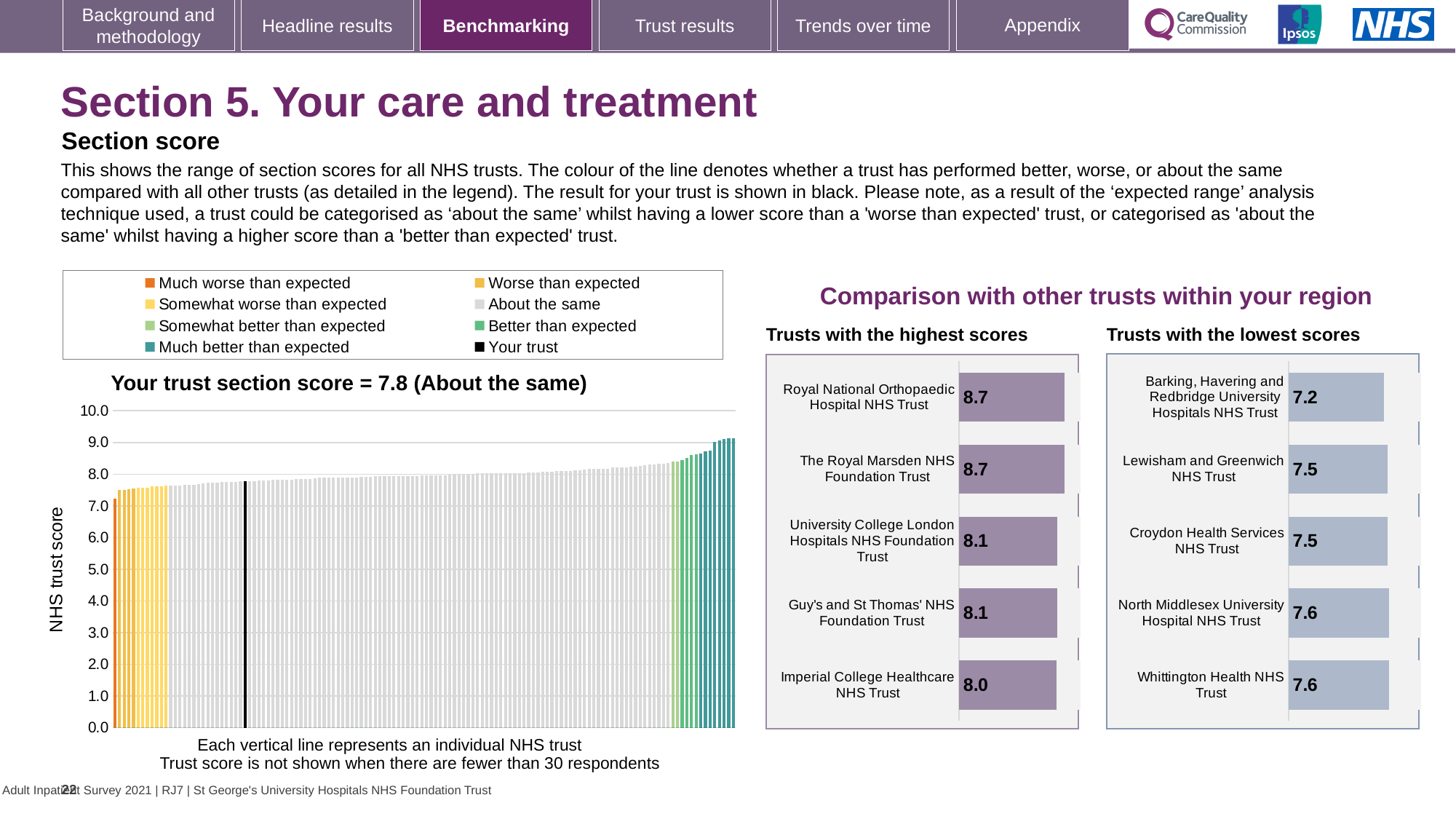
On the 'Trusts with the lowest scores' chart, what is the score for Croydon Health Services NHS Trust? 7.5 On the 'Trusts with the highest scores' chart, what is the score for Imperial College Healthcare NHS Trust? 8.0 On the 'Your trust section score' chart, is the value of the leftmost (lowest) bar greater or less than 7.0? greater On the 'Trusts with the highest scores' chart, what is the difference between the scores of Royal National Orthopaedic Hospital NHS Trust and Imperial College Healthcare NHS Trust? 0.7 On the 'Trusts with the highest scores' chart, which trust has the lowest score? Imperial College Healthcare NHS Trust On the 'Your trust section score' chart, what is the trust's section score? 7.8 How many entries does the legend above the 'Your trust section score' chart list? 8 What kind of chart is the 'Your trust section score' chart? bar chart On the 'Your trust section score' chart, do the trust scores rise or fall from left to right along the x axis? rise On the 'Your trust section score' chart, which category does the trust's score fall into? About the same How many trusts are shown on the 'Trusts with the lowest scores' chart? 5 On the 'Trusts with the lowest scores' chart, which trust has the lowest score? Barking, Havering and Redbridge University Hospitals NHS Trust